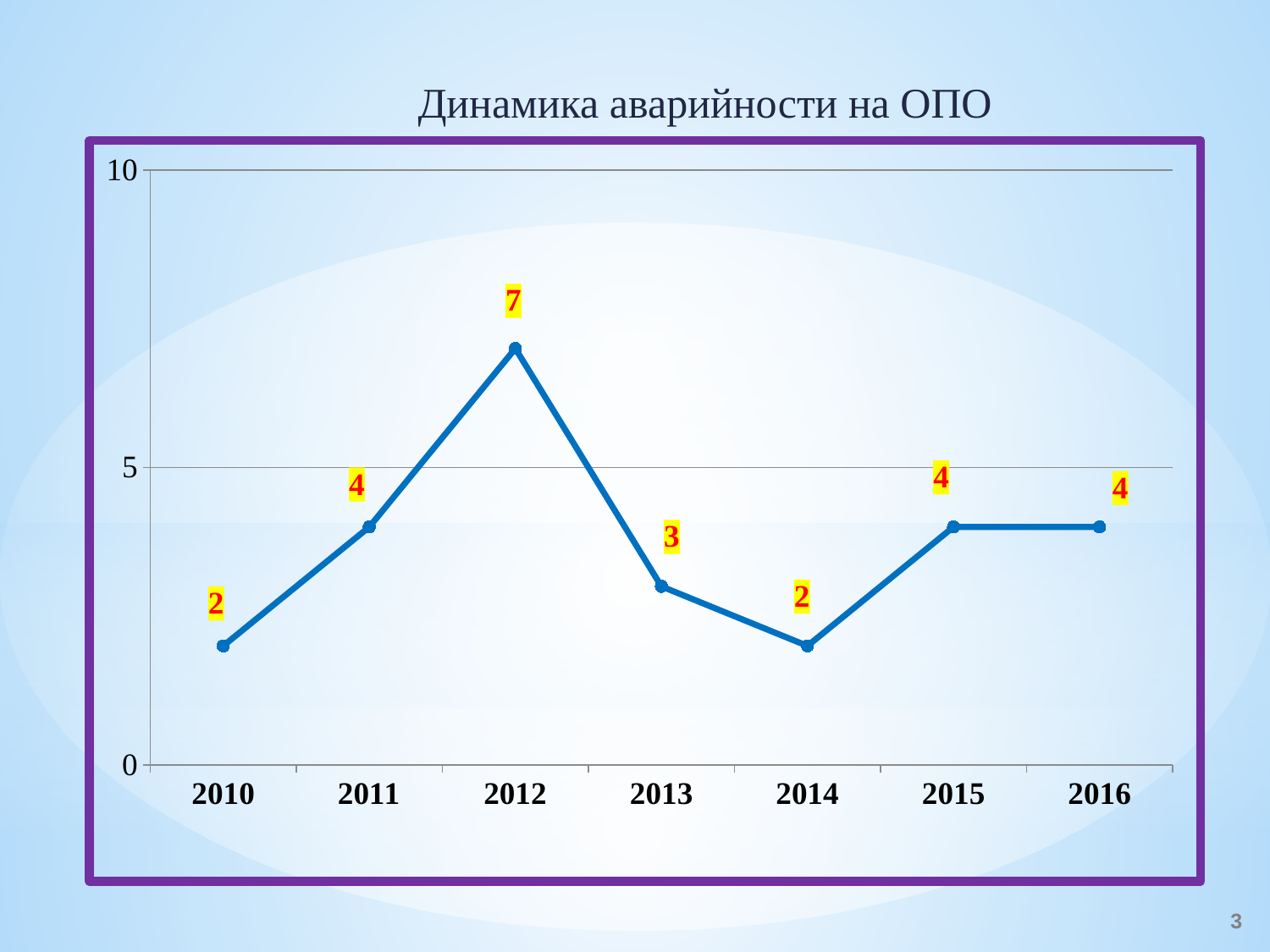
Is the value for 2012 greater or less than 5? greater What kind of chart is shown? line chart What is the difference between the values for 2016 and 2014? 2 What is the value for 2013? 3 Which year has the highest value? 2012 What is the value for 2010? 2 Do the values rise or fall from 2012 to 2014? fall What is the difference between the values for 2012 and 2013? 4 How many years are plotted on the x axis? 7 Which is larger, the value for 2011 or the value for 2013? 2011 What is the value for 2012? 7 What is the title of the chart? Динамика аварийности на ОПО